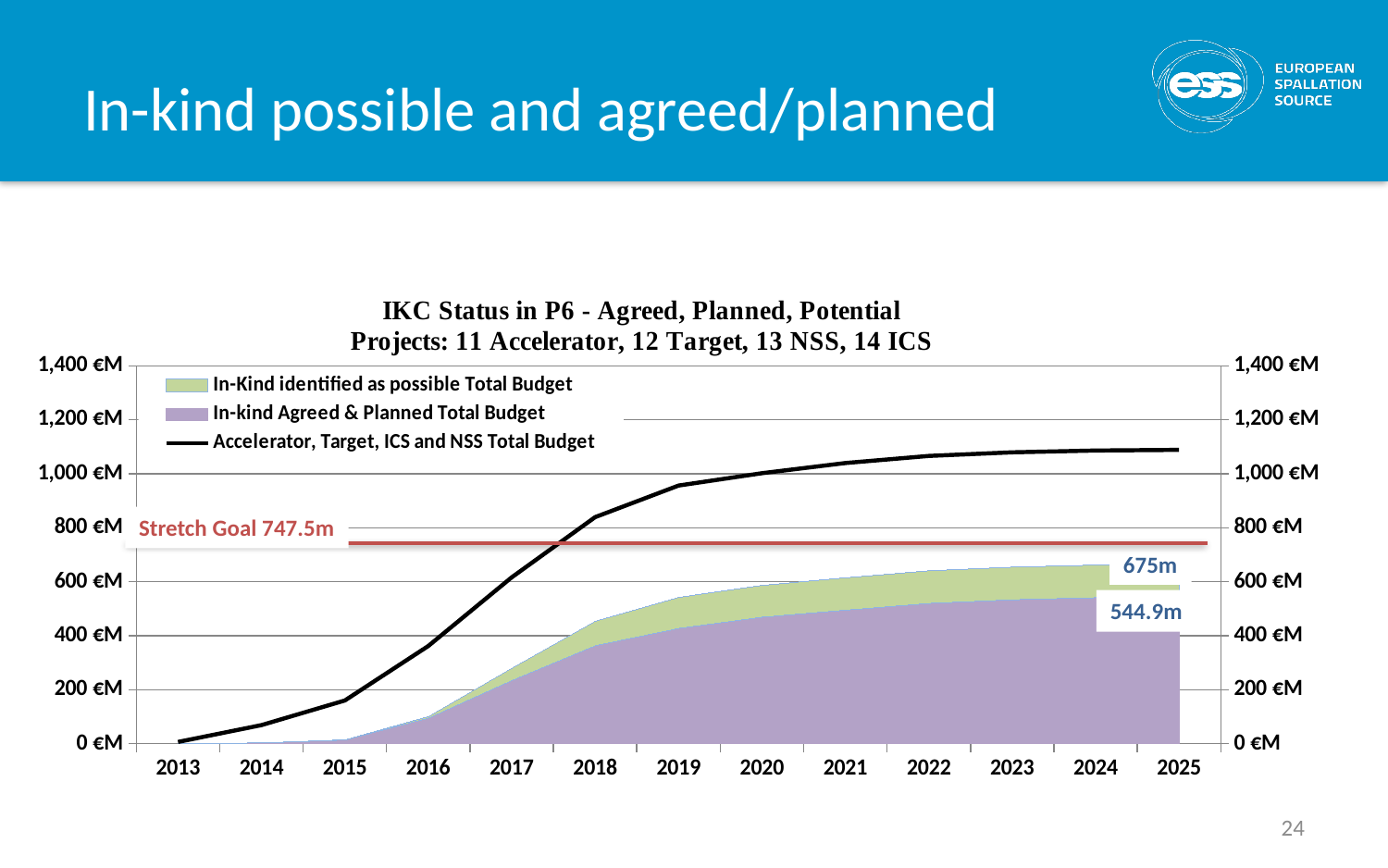
What is the value of the Stretch Goal shown on the chart? 747.5m Is the Accelerator, Target, ICS and NSS Total Budget in 2025 greater or less than 1,000 €M? greater Does the Accelerator, Target, ICS and NSS Total Budget rise or fall from 2013 to 2025? rise What is the first line of the chart's title? IKC Status in P6 - Agreed, Planned, Potential What value is labelled on the chart for the In-Kind identified as possible Total Budget? 675m What kind of chart is shown on the slide? combination area and line chart What value is labelled on the chart for the In-kind Agreed & Planned Total Budget? 544.9m How many years are shown on the x axis? 13 What is the difference between the labelled In-Kind identified as possible value (675m) and the labelled In-kind Agreed & Planned value (544.9m)? 130.1m Is the Accelerator, Target, ICS and NSS Total Budget in 2016 greater or less than 600 €M? less How many series does the legend list? 3 In which year is the Accelerator, Target, ICS and NSS Total Budget lowest? 2013